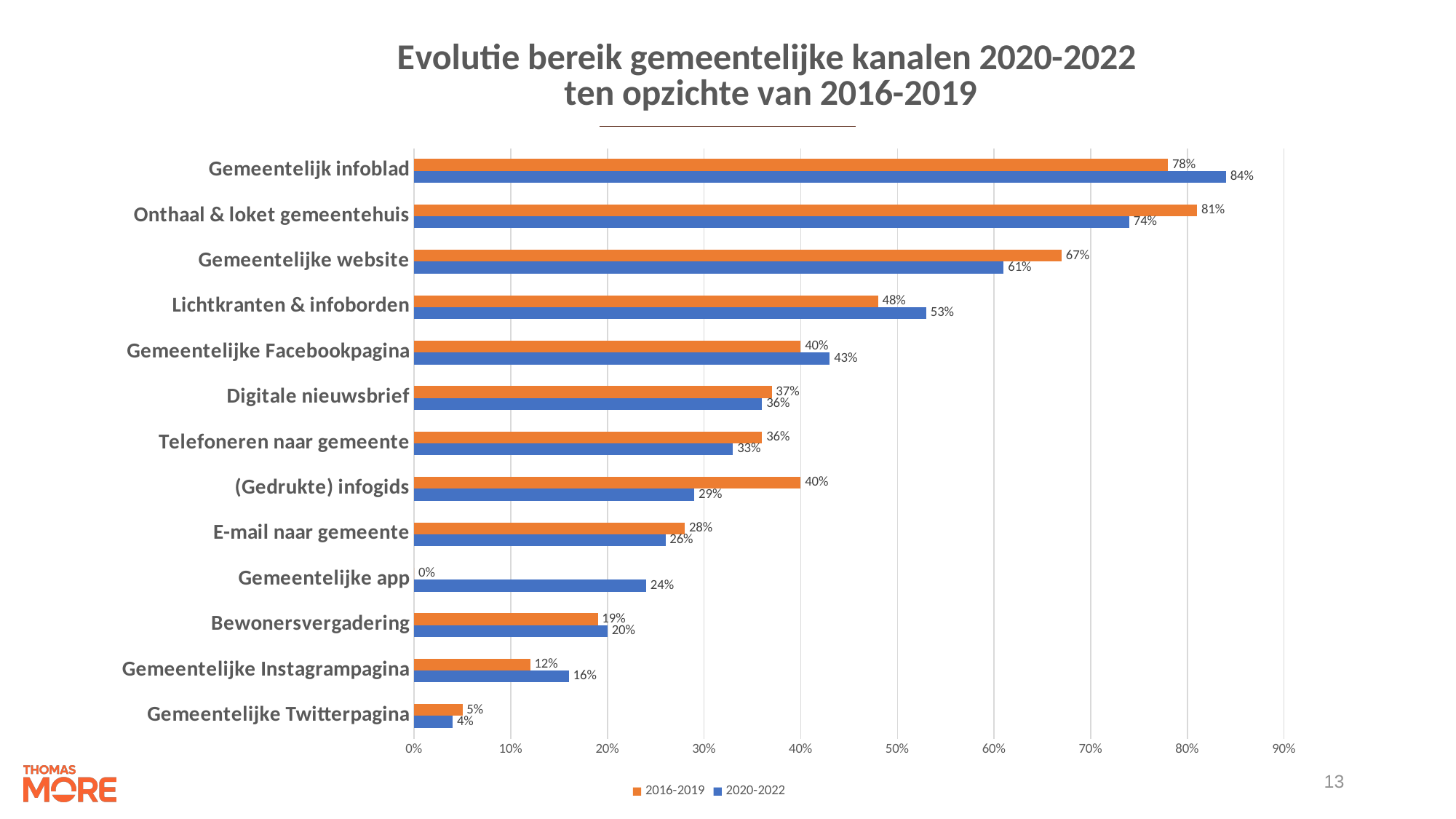
How many series does the legend list? 2 What is the 2016-2019 value for (Gedrukte) infogids? 40% What is the 2020-2022 value for Gemeentelijke app? 24% What is the 2020-2022 value for Gemeentelijk infoblad? 84% What is the difference between the 2020-2022 and 2016-2019 values for Gemeentelijke app? 24% How many categories are shown on the chart? 13 What kind of chart is shown on the slide? Bar chart What is the difference between the 2016-2019 and 2020-2022 values for (Gedrukte) infogids? 11% Which category has the lowest 2020-2022 value? Gemeentelijke Twitterpagina Which category has the highest 2016-2019 value? Onthaal & loket gemeentehuis Is the 2020-2022 value for Gemeentelijke website greater or less than 70%? less For Onthaal & loket gemeentehuis, which period has the larger value, 2016-2019 or 2020-2022? 2016-2019